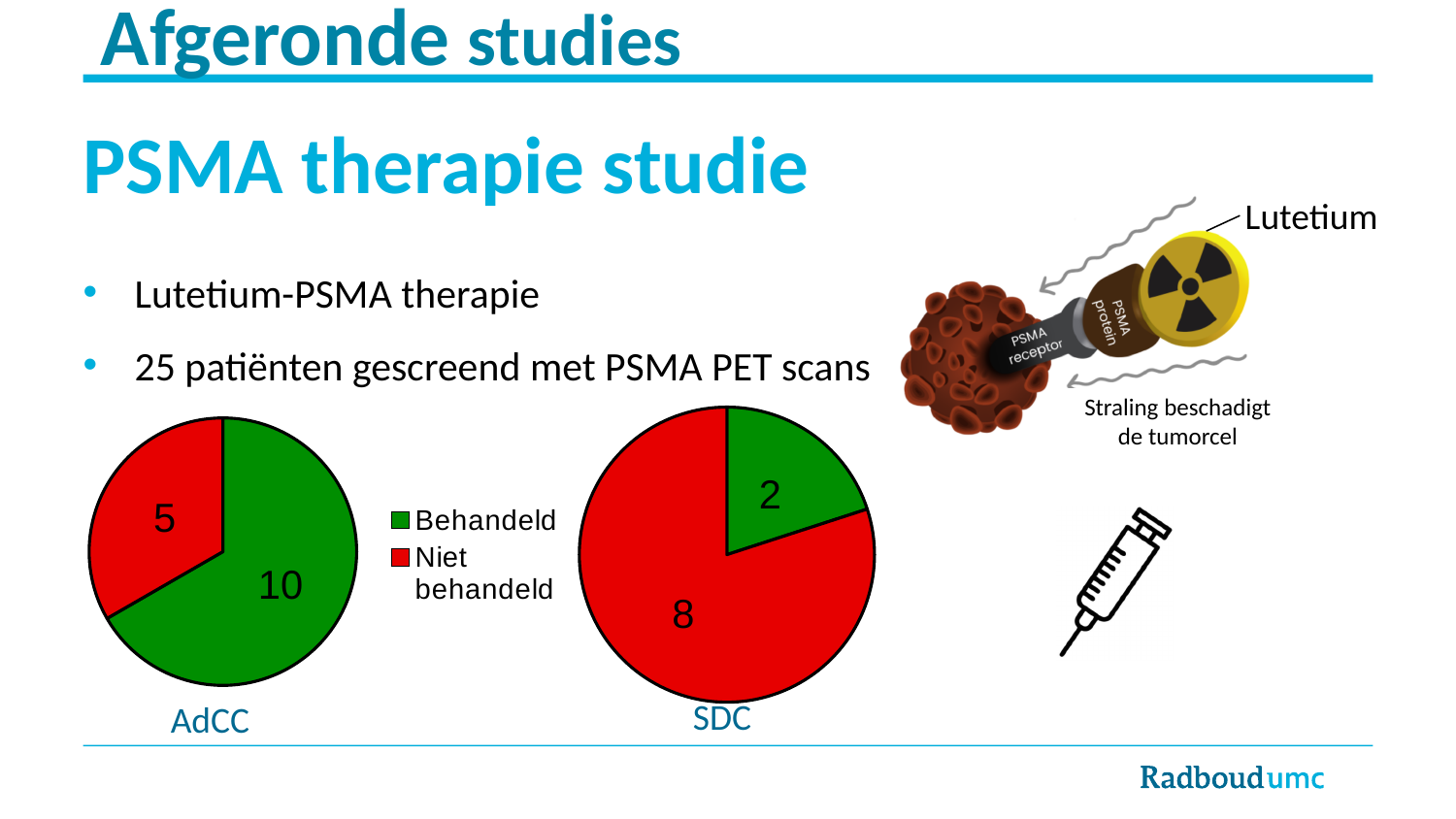
In the AdCC pie chart, what is the difference between Behandeld and Niet behandeld? 5 In the SDC pie chart, what is the value for Behandeld? 2 In the SDC pie chart, what is the value for Niet behandeld? 8 In the SDC pie chart, which category has the smallest slice? Behandeld In the AdCC pie chart, which category has the largest slice? Behandeld Which is larger: Behandeld in the AdCC chart or Behandeld in the SDC chart? AdCC How many entries does the legend between the two pie charts list? 2 In the SDC pie chart, what share of the total does Niet behandeld represent? 80% In the SDC pie chart, what is the difference between Niet behandeld and Behandeld? 6 What kind of chart is the AdCC chart? Pie chart In the AdCC pie chart, what is the value for Niet behandeld? 5 In the AdCC pie chart, what is the value for Behandeld? 10